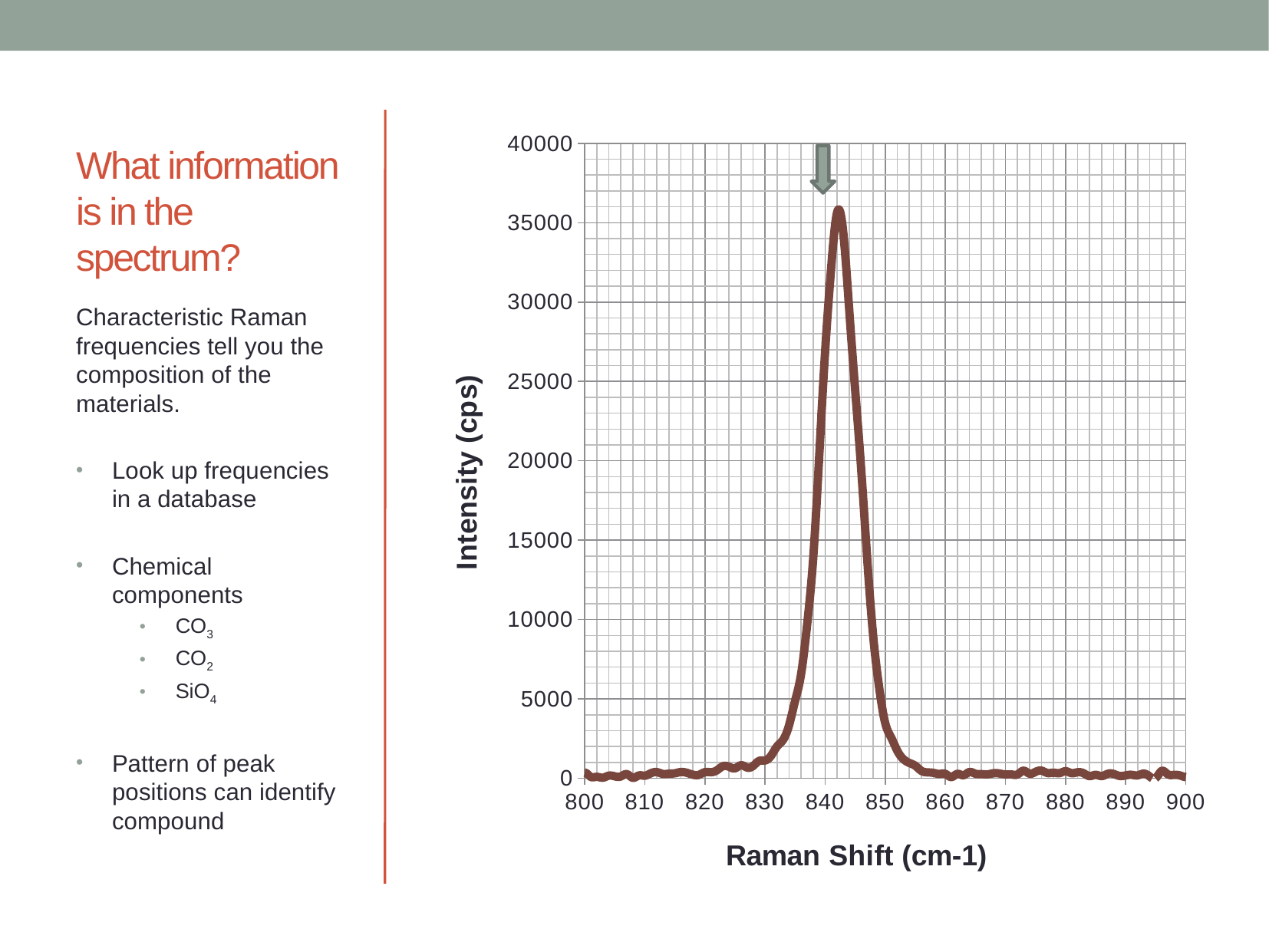
What kind of chart is shown on the slide? line chart Do the intensity values rise or fall as the Raman shift increases from 850 to 860? fall Is the intensity at a Raman shift of 800 greater or less than 5000? less Which is larger, the intensity at a Raman shift of 840 or at 880? 840 Is the peak intensity of the spectrum greater or less than 30000? greater What is the title of the x axis of the chart? Raman Shift (cm-1) Is the intensity at a Raman shift of 870 greater or less than 10000? less Do the intensity values rise or fall as the Raman shift increases from 830 to 840? rise What is the title of the y axis of the chart? Intensity (cps) What is the highest value labelled on the y axis? 40000 Between which two labelled x-axis ticks does the peak of the spectrum lie? 840 and 850